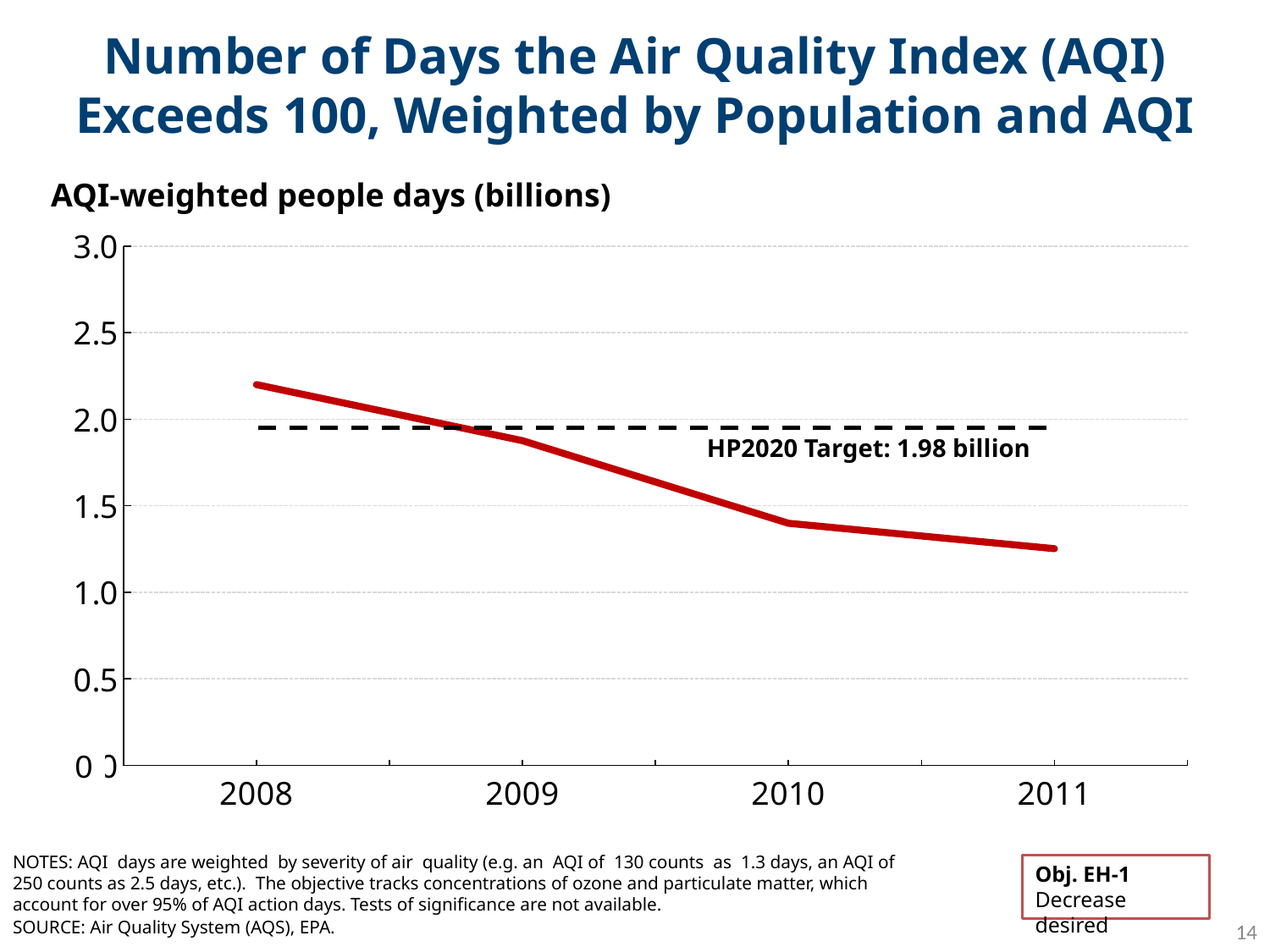
Which year has the larger value, 2008 or 2011? 2008 What is the HP2020 Target value shown on the chart? 1.98 billion What objective number is shown in the box at the bottom right of the slide? Obj. EH-1 Which year has the lowest value of AQI-weighted people days? 2011 How many years are plotted on the x axis of the chart? 4 Is the value for 2008 greater or less than 2.0 billion? greater What is the label of the y axis of the chart? AQI-weighted people days (billions) Which year has the highest value of AQI-weighted people days? 2008 What kind of chart is shown on the slide? line chart Is the value for 2010 greater or less than 1.5 billion? less Do the AQI-weighted people days rise or fall from 2008 to 2011? fall Is the value for 2011 greater or less than 1.0 billion? greater